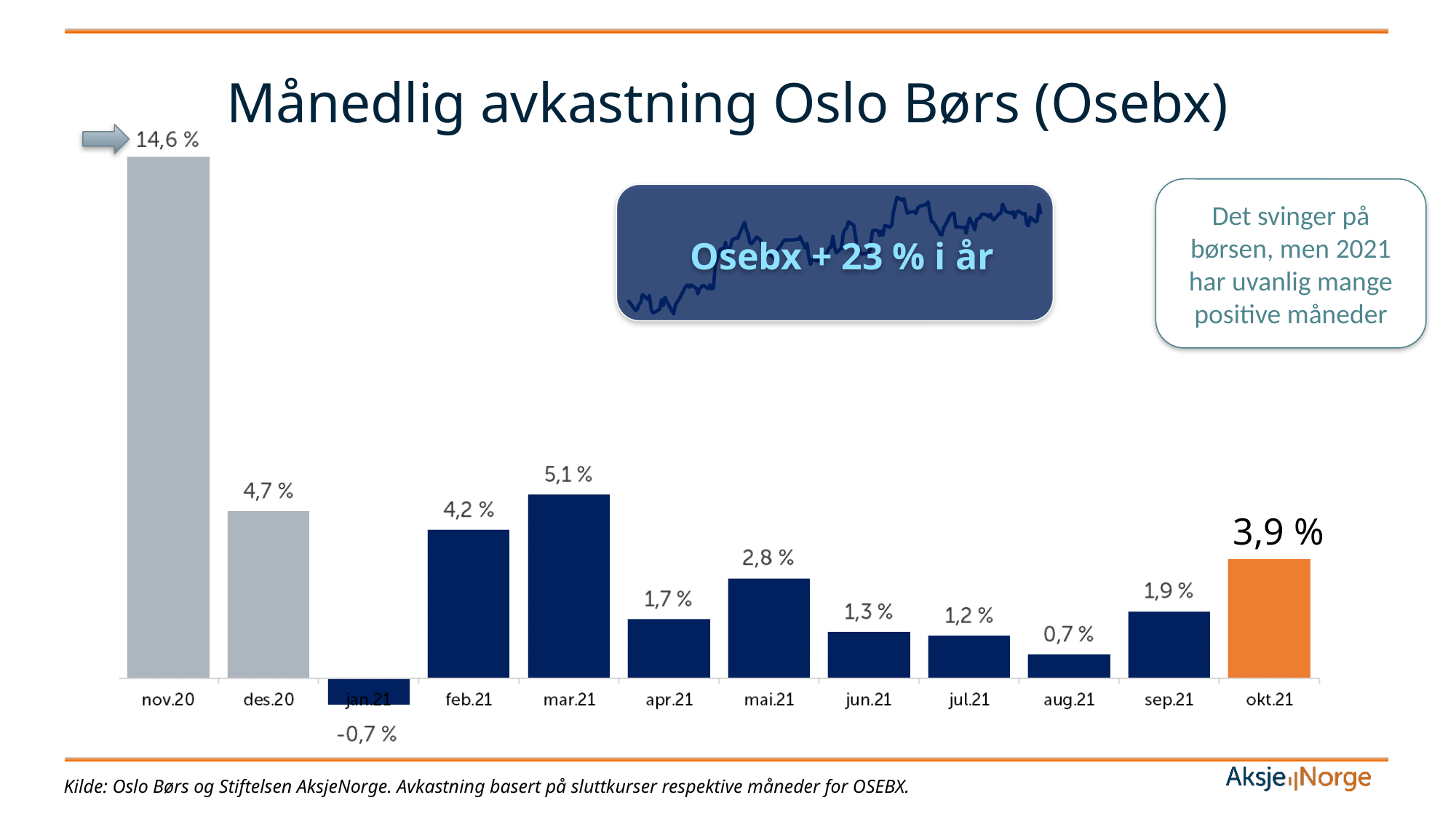
What is the difference between the returns for mar.21 and feb.21? 0,9 % What is the title of the chart? Månedlig avkastning Oslo Børs (Osebx) What type of chart is shown on the slide? bar chart What is the monthly return shown for okt.21? 3,9 % Which month has the highest monthly return in the chart? nov.20 What is the monthly return shown for nov.20? 14,6 % Which month's bar is coloured orange? okt.21 What is the monthly return shown for mar.21? 5,1 % Which month has the larger return, des.20 or okt.21? des.20 Which month has the lowest monthly return in the chart? jan.21 How many months are shown in the chart? 12 What is the monthly return shown for jan.21? -0,7 %